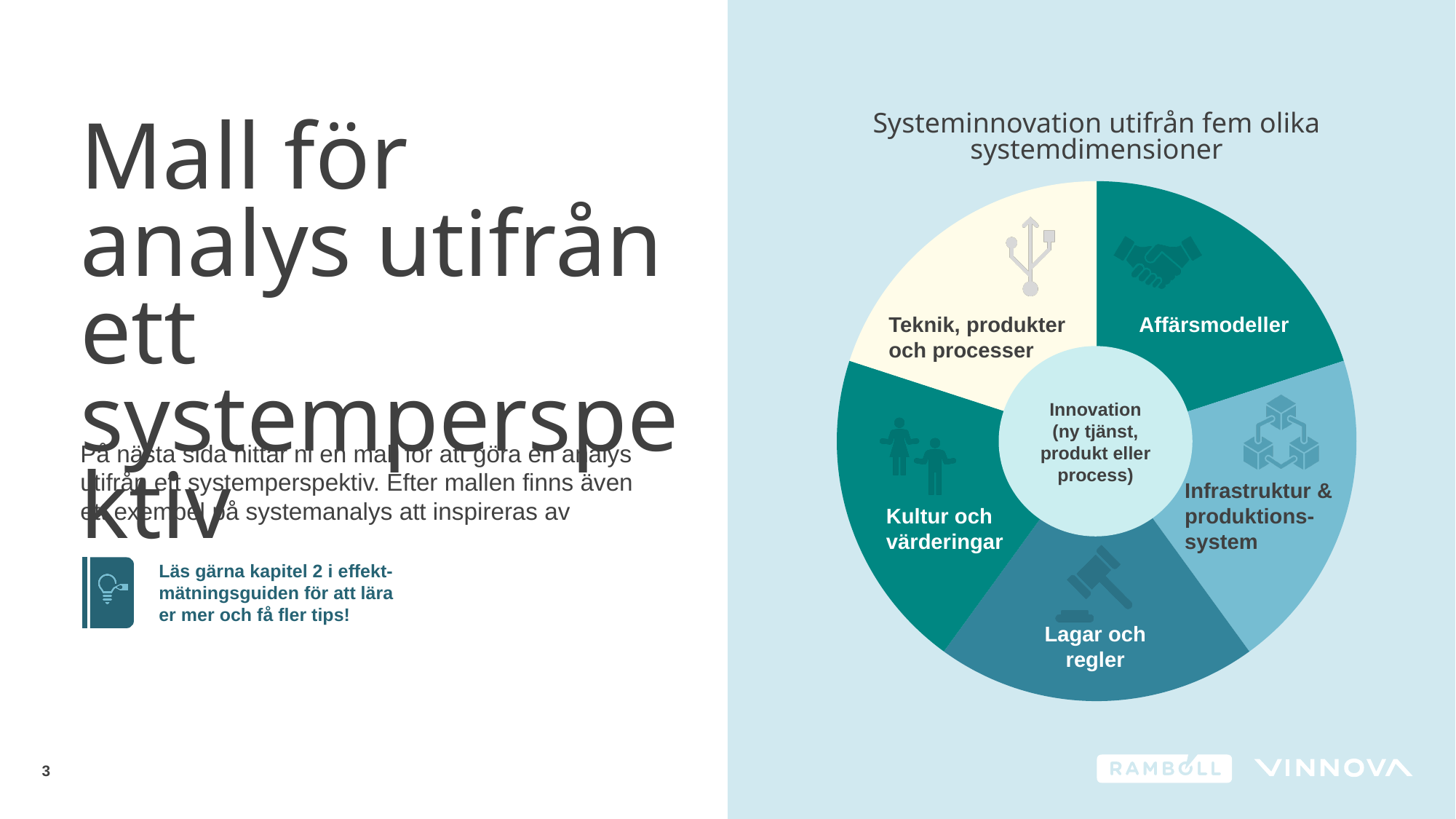
Which segment of the donut chart is labelled with a gavel icon? Lagar och regler Which segment of the donut chart sits between 'Affärsmodeller' and 'Lagar och regler'? Infrastruktur & produktions-system Which segment of the donut chart is shown in a pale yellow colour? Teknik, produkter och processer What text is written in the centre of the donut chart? Innovation (ny tjänst, produkt eller process) How many segments does the donut chart have? 5 What kind of chart is shown on the right side of the slide? Pie chart (donut) Which segment of the donut chart is labelled with an icon of two people? Kultur och värderingar What is the title of the donut chart? Systeminnovation utifrån fem olika systemdimensioner Which segment of the donut chart is labelled with a handshake icon? Affärsmodeller